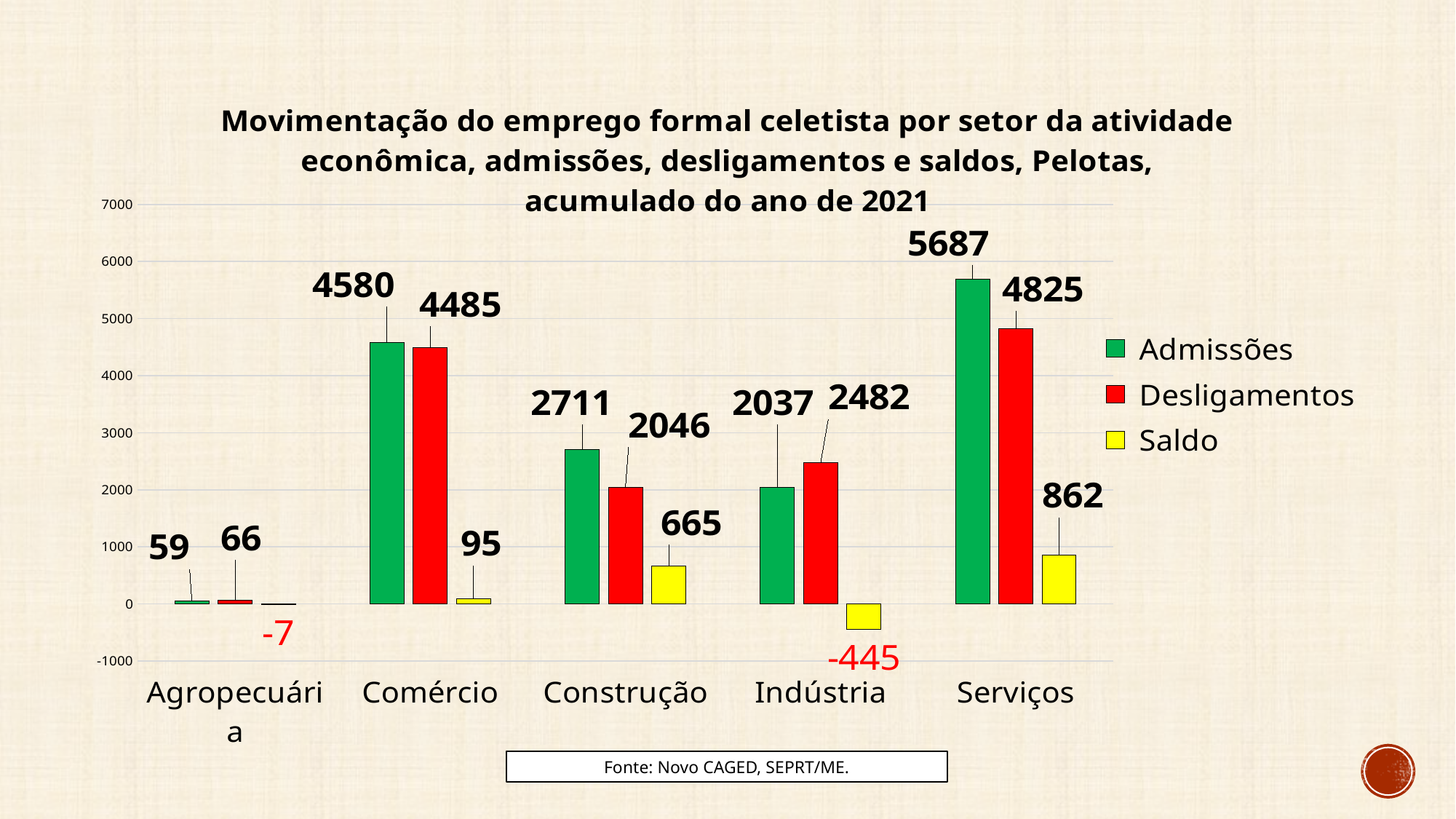
What kind of chart is shown on the slide? Bar chart What is the difference between Admissões and Desligamentos for Construção? 665 What colour represents the Saldo series in the legend? Yellow How many sectors are shown on the x axis? 5 What is the Saldo value for Indústria? -445 What is the value of Admissões for Serviços? 5687 Which sector has the lowest Desligamentos value? Agropecuária How many series does the legend list? 3 What is the value of Desligamentos for Comércio? 4485 Which is larger for Indústria, Admissões or Desligamentos? Desligamentos Which sector has the highest Admissões value? Serviços What is the Saldo value for Agropecuária? -7